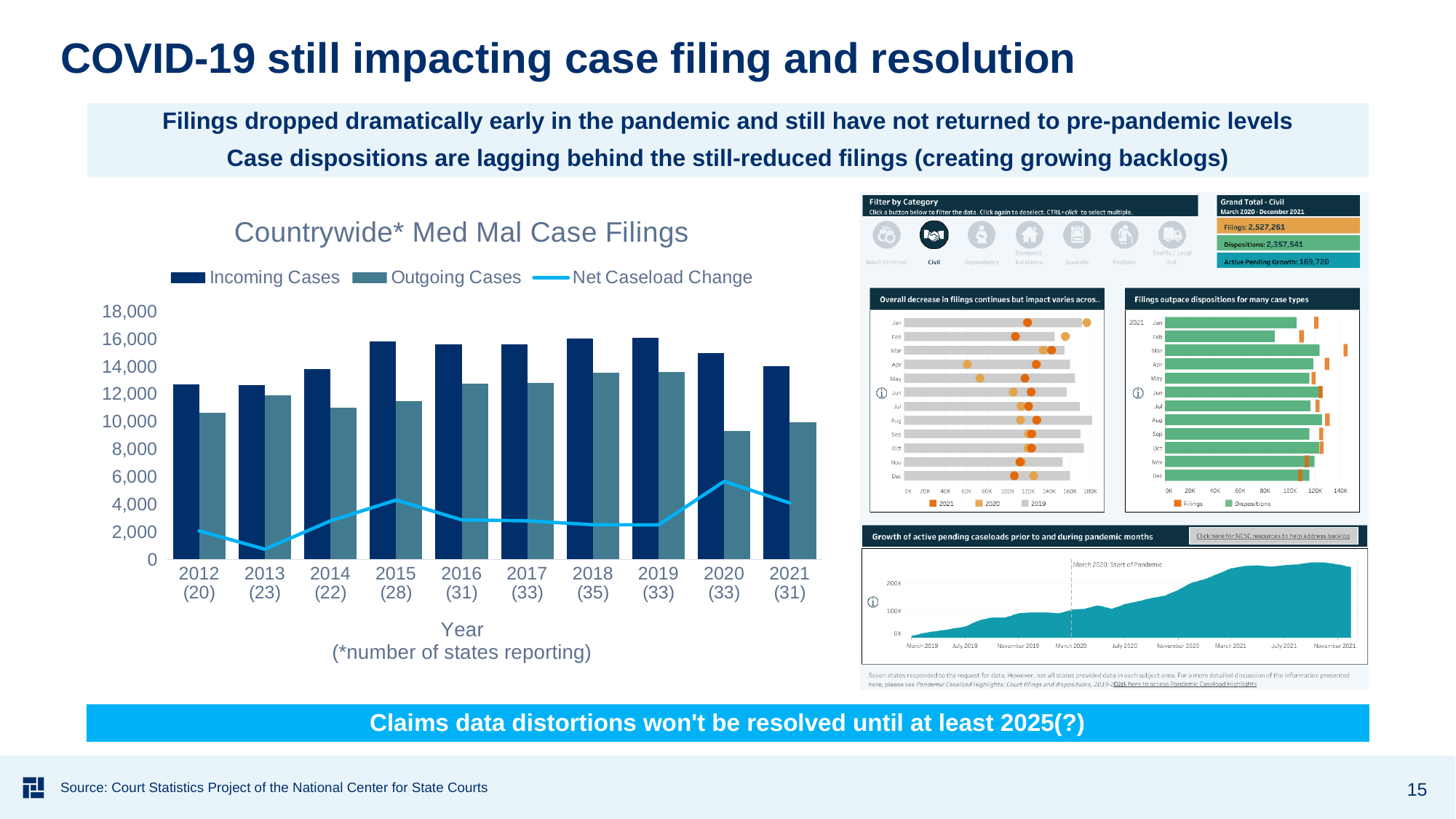
What is the title of the bar chart on the left side of the slide? Countrywide* Med Mal Case Filings In the Countrywide* Med Mal Case Filings chart, which year has the lowest Outgoing Cases bar? 2020 In the Countrywide* Med Mal Case Filings chart, how many states reported in 2018 according to the x-axis label? 35 In the Countrywide* Med Mal Case Filings chart, how many series does the legend list? 3 In the Countrywide* Med Mal Case Filings chart, is the Outgoing Cases value for 2020 greater or less than 10,000? less In the Countrywide* Med Mal Case Filings chart, which year has the highest point on the Net Caseload Change line? 2020 In the Countrywide* Med Mal Case Filings chart, is the Incoming Cases value for 2015 greater or less than 14,000? greater What kind of chart is the Countrywide* Med Mal Case Filings chart? Bar chart with a line In the Countrywide* Med Mal Case Filings chart, which year has the lowest point on the Net Caseload Change line? 2013 In the Countrywide* Med Mal Case Filings chart, do Outgoing Cases rise or fall from 2019 to 2020? fall In the Countrywide* Med Mal Case Filings chart, how many years are shown on the x axis? 10 In the Countrywide* Med Mal Case Filings chart, which is larger in 2020: Incoming Cases or Outgoing Cases? Incoming Cases